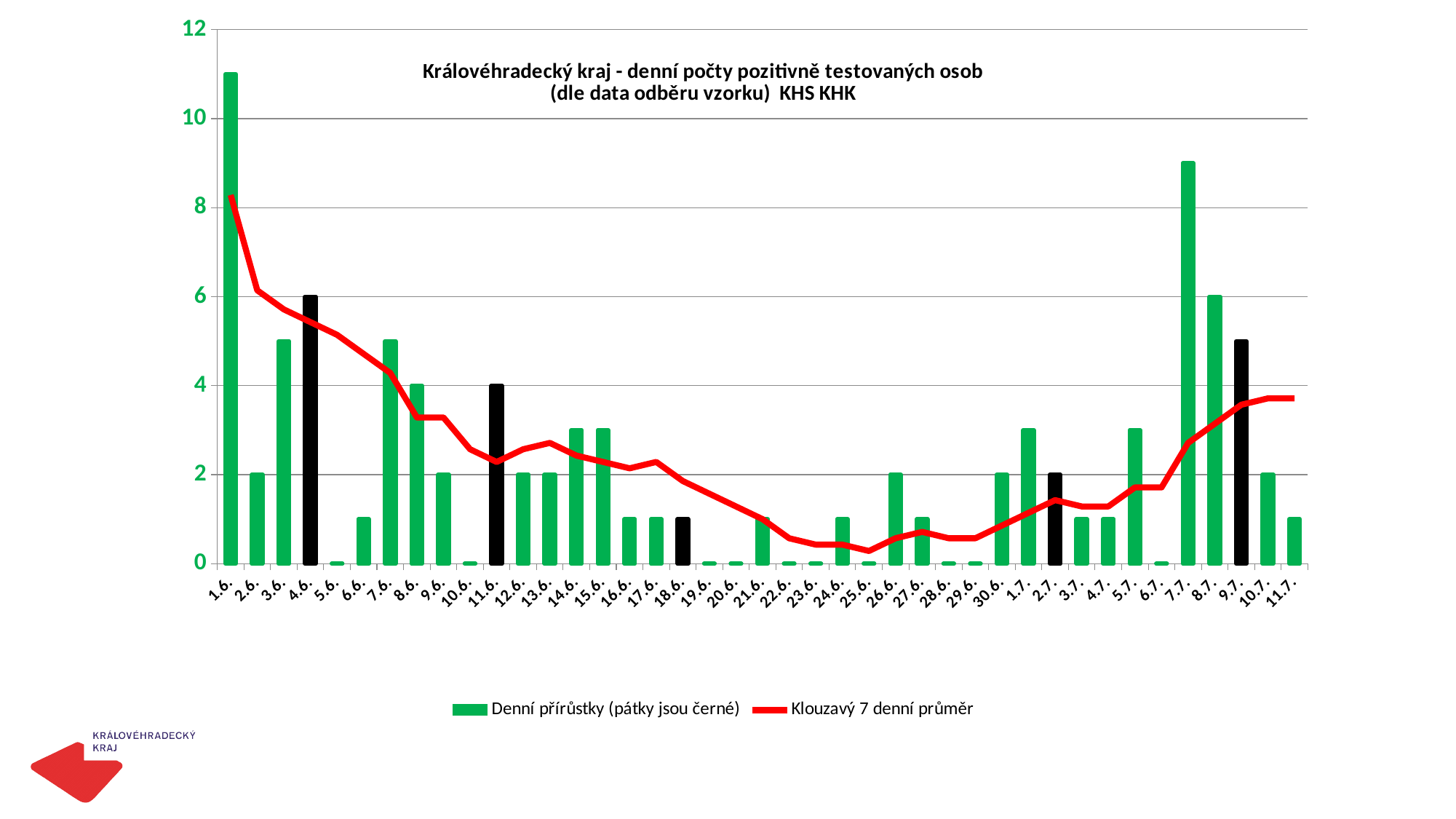
Which date has the highest daily count of positively tested persons? 1.6. Does the 7-day moving average (red line) rise or fall from 1.6. to 25.6.? fall How many series does the legend list? 2 What is the daily count for 4.6.? 6 Which is larger, the daily count for 1.6. or for 7.7.? 1.6. What is the daily count for 11.6.? 4 Is the daily count for 7.7. greater or less than 8? greater What is the daily count for 8.7.? 6 What is the daily count for 25.6.? 0 What kind of chart is shown on the slide? bar chart with a line What is the difference between the daily counts for 4.6. and 11.6.? 2 Is the daily count for 1.6. greater or less than 10? greater